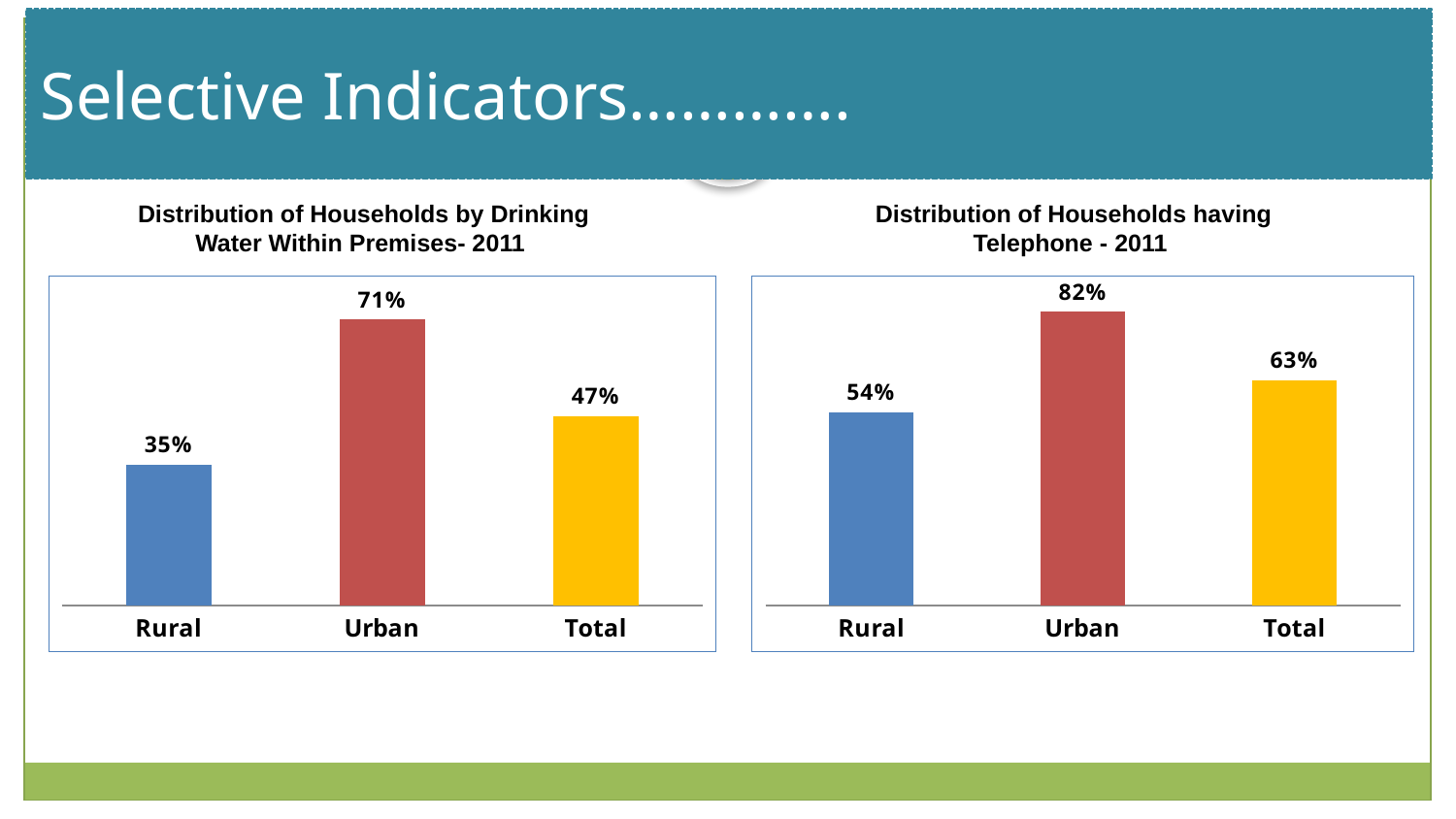
In the 'Distribution of Households by Drinking Water Within Premises- 2011' chart, what is the difference between the Urban and Rural values? 36% In the 'Distribution of Households by Drinking Water Within Premises- 2011' chart, what is the value for Urban? 71% In the 'Distribution of Households having Telephone - 2011' chart, what is the difference between the Urban and Total values? 19% In the 'Distribution of Households having Telephone - 2011' chart, which category has the lowest value? Rural What colour is the Urban bar in the 'Distribution of Households having Telephone - 2011' chart? Red In the 'Distribution of Households by Drinking Water Within Premises- 2011' chart, what is the value for Rural? 35% Which is larger: the Rural value in the Drinking Water chart or the Rural value in the Telephone chart? Telephone chart (54%) In the 'Distribution of Households by Drinking Water Within Premises- 2011' chart, which category has the highest value? Urban In the 'Distribution of Households having Telephone - 2011' chart, what is the value for Total? 63% In the 'Distribution of Households having Telephone - 2011' chart, what is the value for Rural? 54% How many categories are shown in the 'Distribution of Households having Telephone - 2011' chart? 3 What type of chart is the 'Distribution of Households by Drinking Water Within Premises- 2011' chart? Bar chart